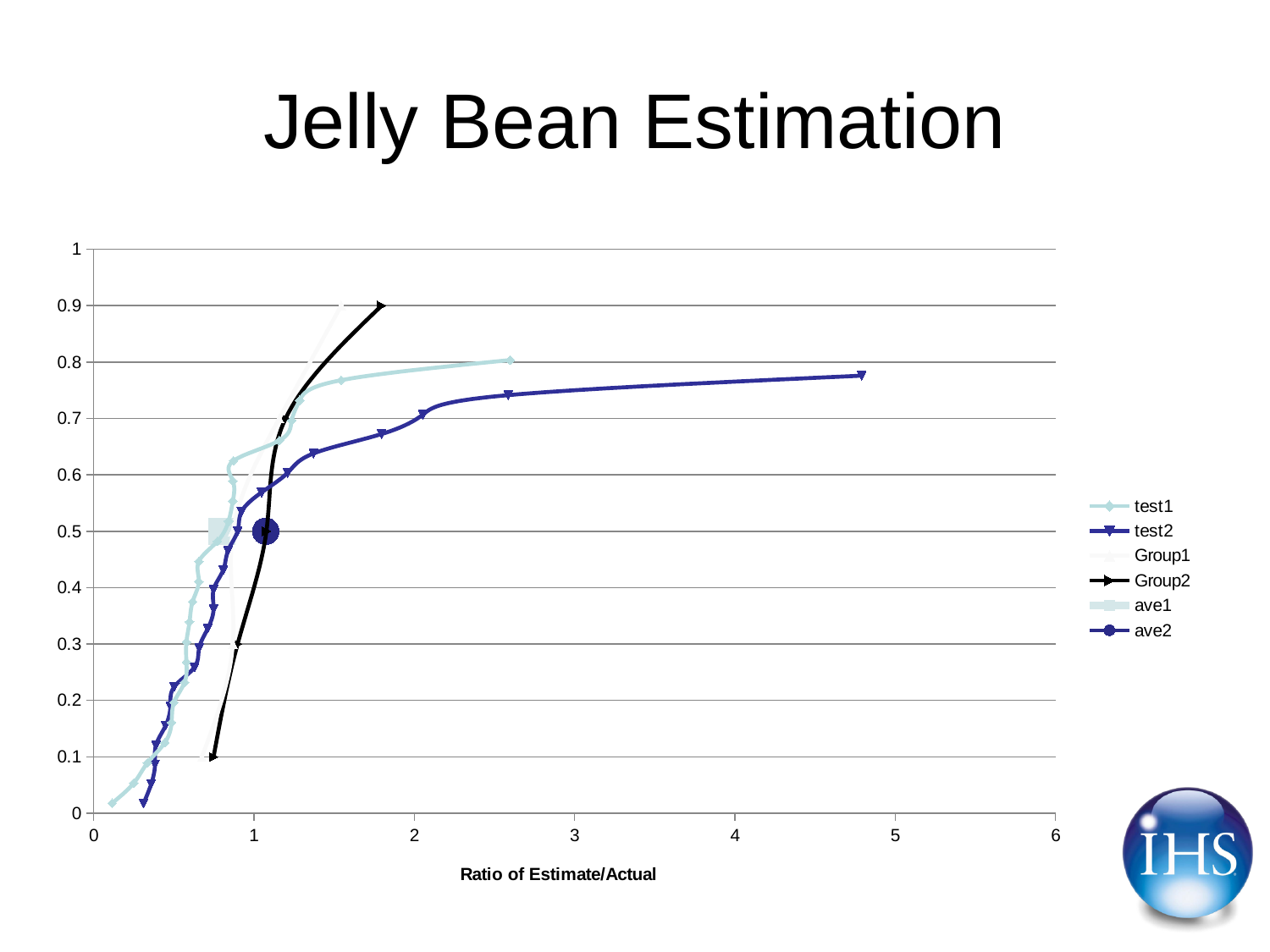
Is the x value of the topmost point of the Group2 series greater or less than 2? less What is the label of the x axis? Ratio of Estimate/Actual Which series reaches the highest y value on the chart? Group1 and Group2 (both reach 0.9) What is the title of the chart? Jelly Bean Estimation Is the largest x value reached by the test1 series greater or less than 3? less Along the x axis, do the y values of the test2 series rise or fall? rise Is the x value of the ave1 marker greater or less than 1? less What kind of chart is shown on the slide? line chart How many series does the legend list? 6 Which series extends to a larger x value, test1 or test2? test2